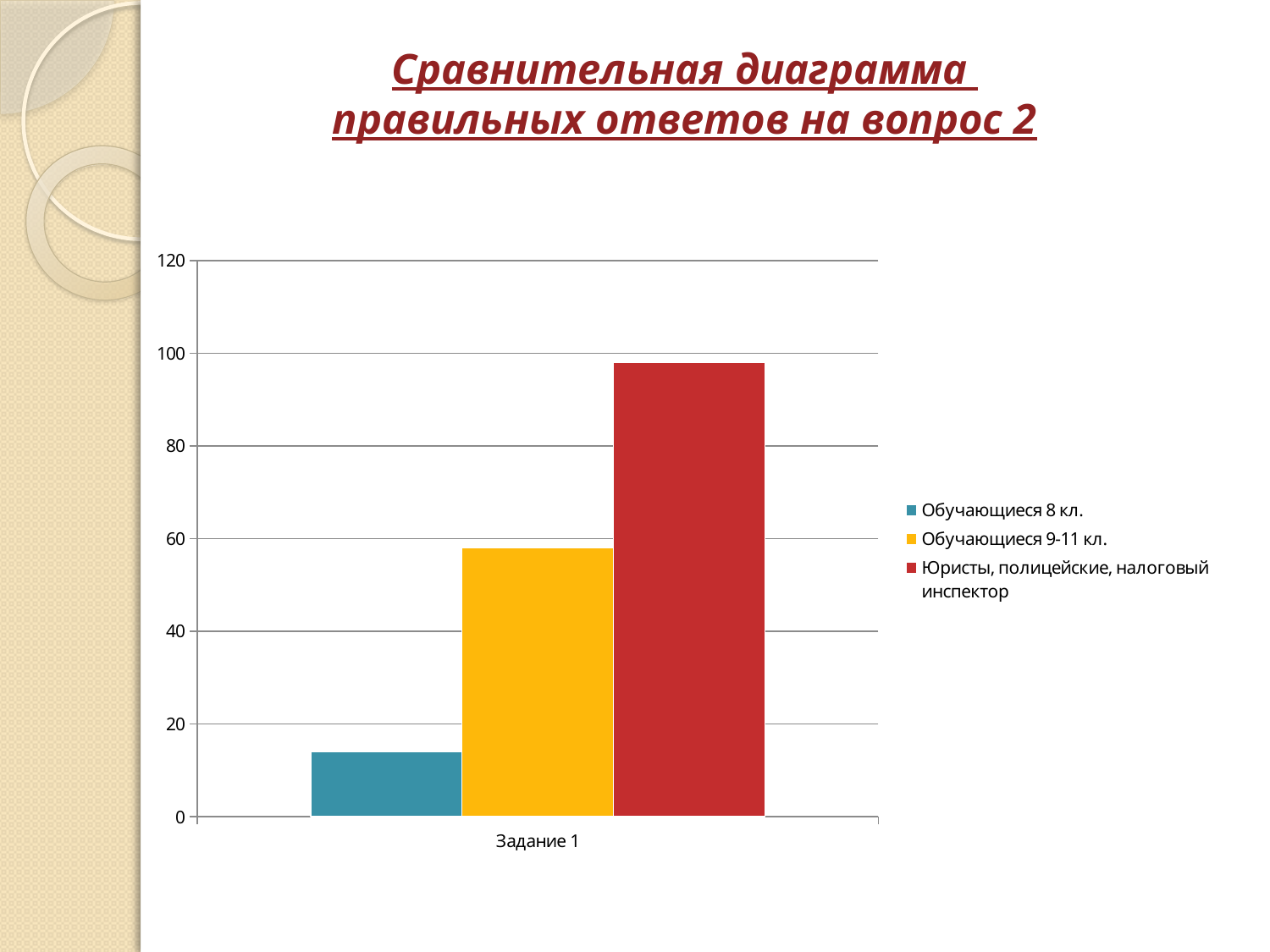
What colour is the bar for Обучающиеся 9-11 кл.? yellow What kind of chart is shown on the slide? bar chart Is the value for Обучающиеся 9-11 кл. greater or less than 40? greater How many series does the legend list? 3 Is the value for Обучающиеся 8 кл. greater or less than 20? less Which is larger: the value for Юристы, полицейские, налоговый инспектор or the value for Обучающиеся 9-11 кл.? Юристы, полицейские, налоговый инспектор What is the label of the category on the x axis? Задание 1 Which is larger: the value for Обучающиеся 9-11 кл. or the value for Обучающиеся 8 кл.? Обучающиеся 9-11 кл. How many categories are shown on the x axis? 1 Is the value for Юристы, полицейские, налоговый инспектор greater or less than 80? greater Which series has the lowest value for Задание 1? Обучающиеся 8 кл. Which series has the highest value for Задание 1? Юристы, полицейские, налоговый инспектор